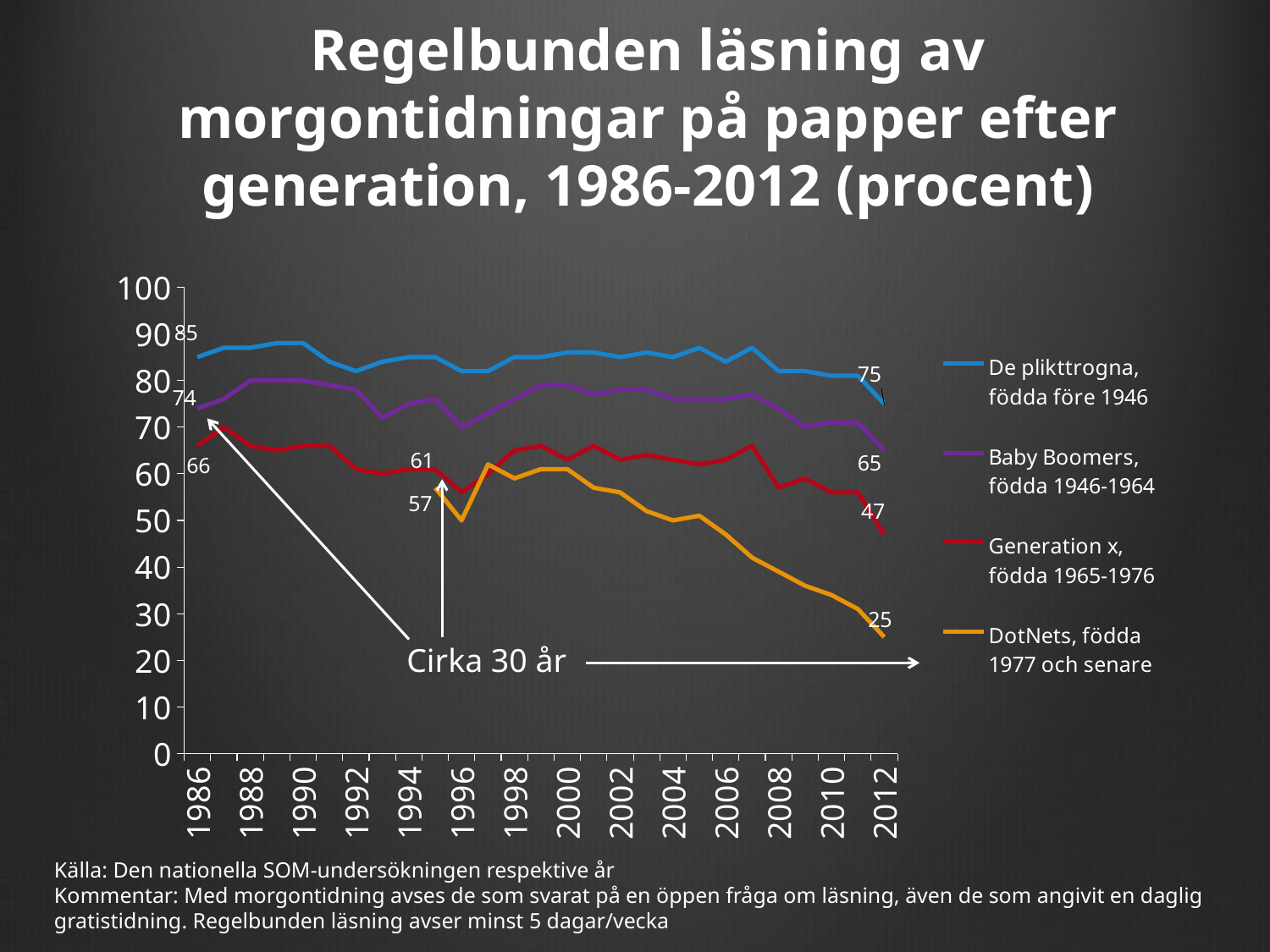
Is the value for 'Baby Boomers, födda 1946-1964' in 2000 greater or less than 70? greater What is the value for 'Generation x, födda 1965-1976' in 2012? 47 Which is larger: the 2012 value for 'Baby Boomers, födda 1946-1964' or the 2012 value for 'Generation x, födda 1965-1976'? Baby Boomers, födda 1946-1964 What is the value for 'DotNets, födda 1977 och senare' in 2012? 25 What is the value for 'De plikttrogna, födda före 1946' in 1986? 85 How many series does the legend list? 4 Which series has the highest value in 2012? De plikttrogna, födda före 1946 What kind of chart is shown on the slide? line chart Which series has the lowest value in 2012? DotNets, födda 1977 och senare What is the value for 'Baby Boomers, födda 1946-1964' in 1986? 74 Does the value for 'DotNets, födda 1977 och senare' rise or fall from 1997 to 2012? fall What is the difference between the 1986 and 2012 values for 'Generation x, födda 1965-1976'? 19